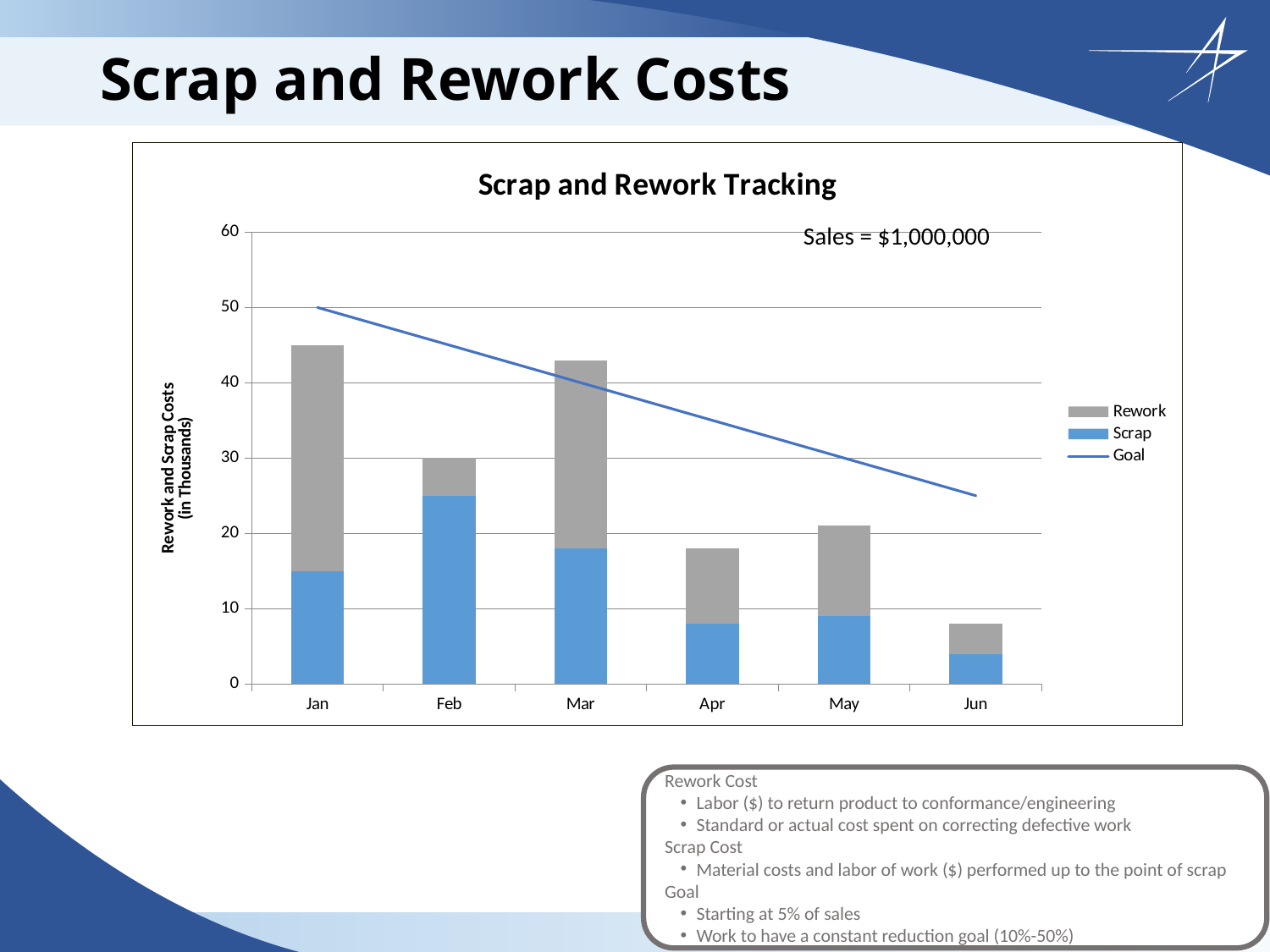
Is the total scrap and rework cost for Jan greater or less than 40? greater How many months are shown on the x axis? 6 Which month has the highest total scrap and rework cost? Jan Which month has the larger Scrap value, Jan or Feb? Feb Which month has the lowest total scrap and rework cost? Jun Does the Goal line rise or fall from Jan to Jun? Falls What is the title of the chart? Scrap and Rework Tracking What kind of chart is shown on the slide? Stacked bar chart with a line Is the total scrap and rework cost for Jun greater or less than 10? less What sales figure is noted on the chart? Sales = $1,000,000 Is the Scrap value for Feb greater or less than 20? greater How many series does the legend list? 3